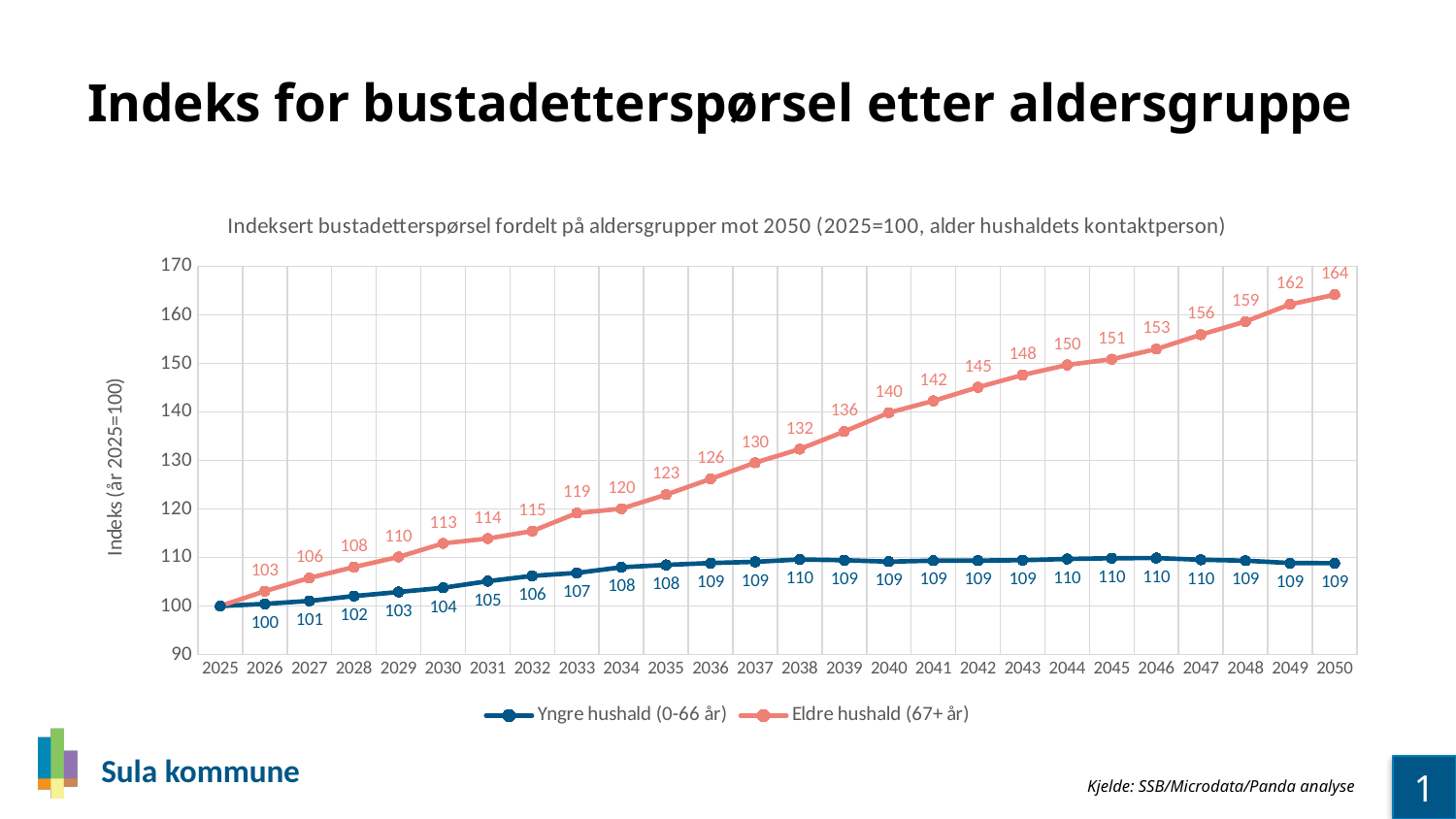
Which series has the larger value in 2045, Yngre hushald (0-66 år) or Eldre hushald (67+ år)? Eldre hushald (67+ år) What kind of chart is shown on the slide? Line chart How many series does the legend list? 2 What is the value for Yngre hushald (0-66 år) in 2050? 109 Is the value for Eldre hushald (67+ år) in 2037 greater or less than 120? greater What is the value for Yngre hushald (0-66 år) in 2035? 108 What is the value for Eldre hushald (67+ år) in 2050? 164 What is the difference between Eldre hushald (67+ år) and Yngre hushald (0-66 år) in 2050? 55 What is the value for Eldre hushald (67+ år) in 2040? 140 How many years are plotted on the x axis? 26 In which year does Eldre hushald (67+ år) reach its highest value? 2050 Does the value for Eldre hushald (67+ år) rise or fall from 2025 to 2050? Rise